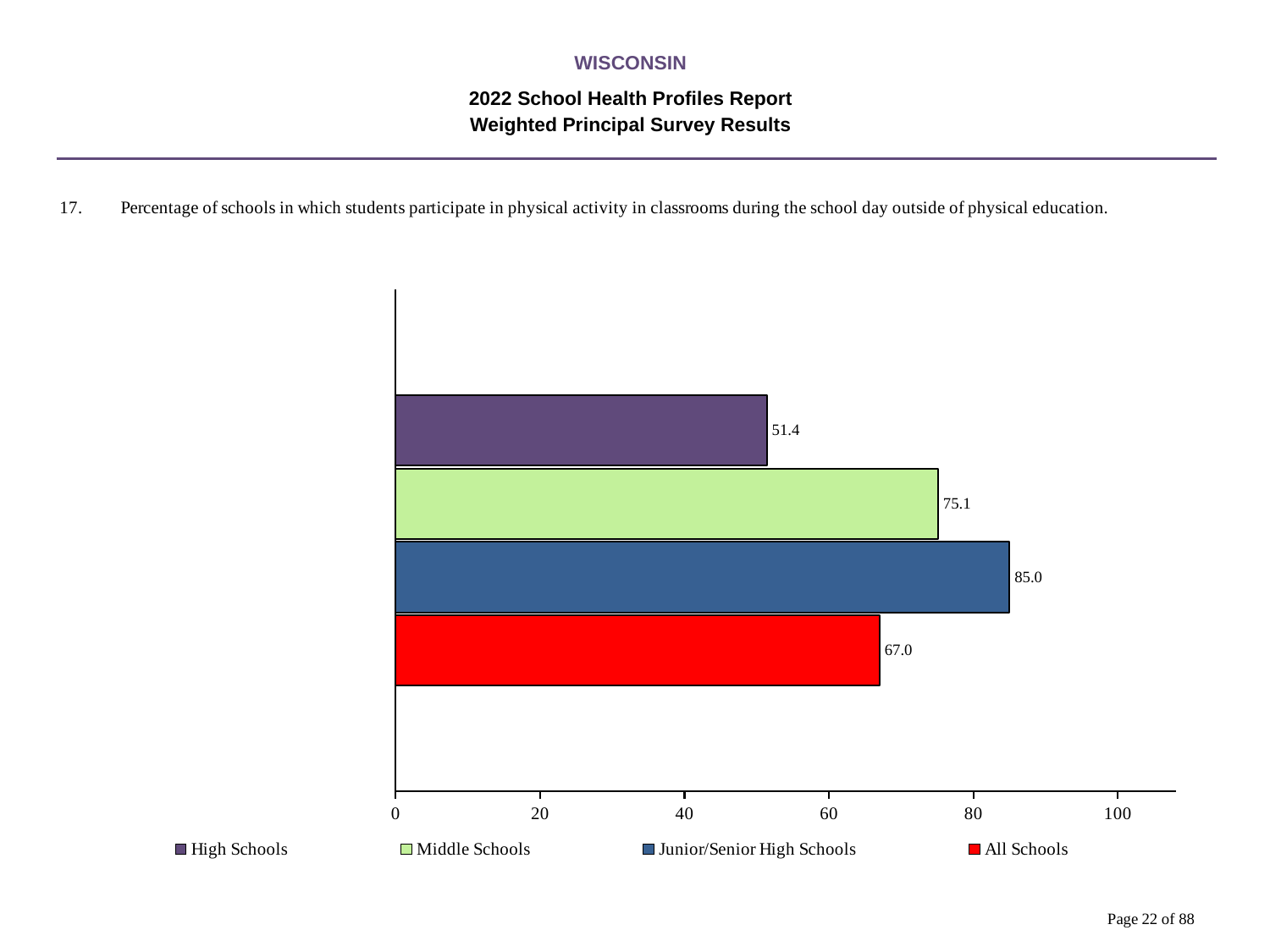
What is the value for Middle Schools? 75.1 How many series does the legend list? 4 What is the value for All Schools? 67.0 What kind of chart is shown on the slide? bar chart What is the value for High Schools? 51.4 Which school type has the lowest value? High Schools Is the value for High Schools greater or less than 60? less What is the value for Junior/Senior High Schools? 85.0 Which is larger, the value for Middle Schools or the value for All Schools? Middle Schools Which school type has the highest value? Junior/Senior High Schools What is the difference between the values for Middle Schools and All Schools? 8.1 What is the difference between the values for Junior/Senior High Schools and High Schools? 33.6